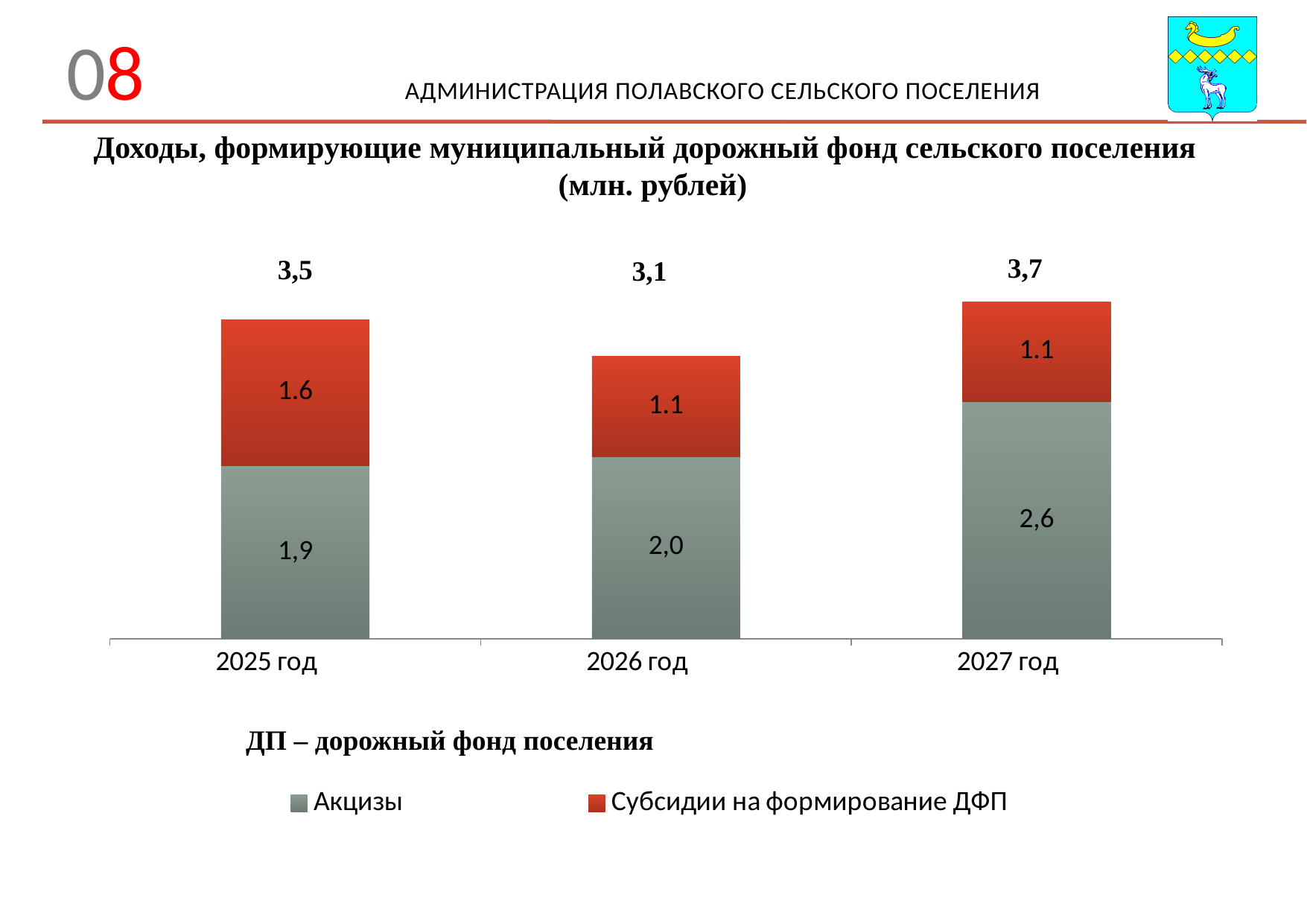
What is the value of Субсидии на формирование ДФП for 2025 год? 1.6 What is the difference between the Акцизы values for 2027 год and 2025 год? 0,7 Which year has the highest total? 2027 год What is the value of Акцизы for 2025 год? 1,9 Which is larger: Субсидии на формирование ДФП in 2025 год or in 2026 год? 2025 год How many years (categories) are shown on the x axis? 3 Which year has the lowest total? 2026 год What is the total shown above the bar for 2026 год? 3,1 What is the value of Акцизы for 2027 год? 2,6 What type of chart is shown on the slide? stacked bar chart Which series is shown in red in the legend? Субсидии на формирование ДФП How many series does the legend list? 2